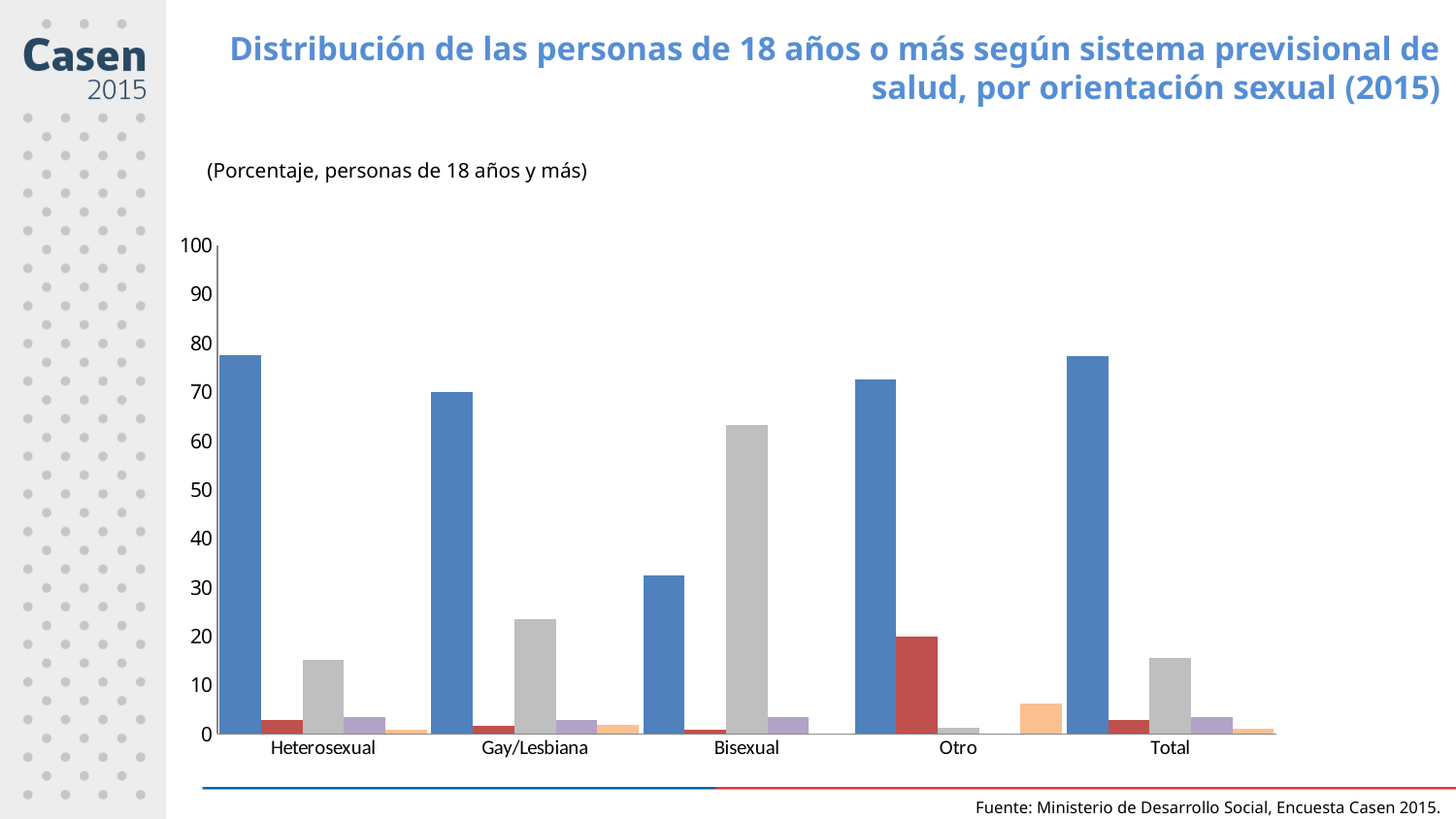
Is the value of the gray bar for Gay/Lesbiana greater or less than 30? less Which is larger: the blue bar for Otro or the blue bar for Bisexual? Otro Which category has the tallest gray bar? Bisexual For the Bisexual category, which is larger: the blue bar or the gray bar? the gray bar What is the source cited at the bottom of the slide? Ministerio de Desarrollo Social, Encuesta Casen 2015 Is the value of the blue bar for Bisexual greater or less than 40? less Is the value of the gray bar for Bisexual greater or less than 60? greater What kind of chart is shown on the slide? bar chart Which category has the lowest blue bar? Bisexual How many categories are shown on the x axis of the chart? 5